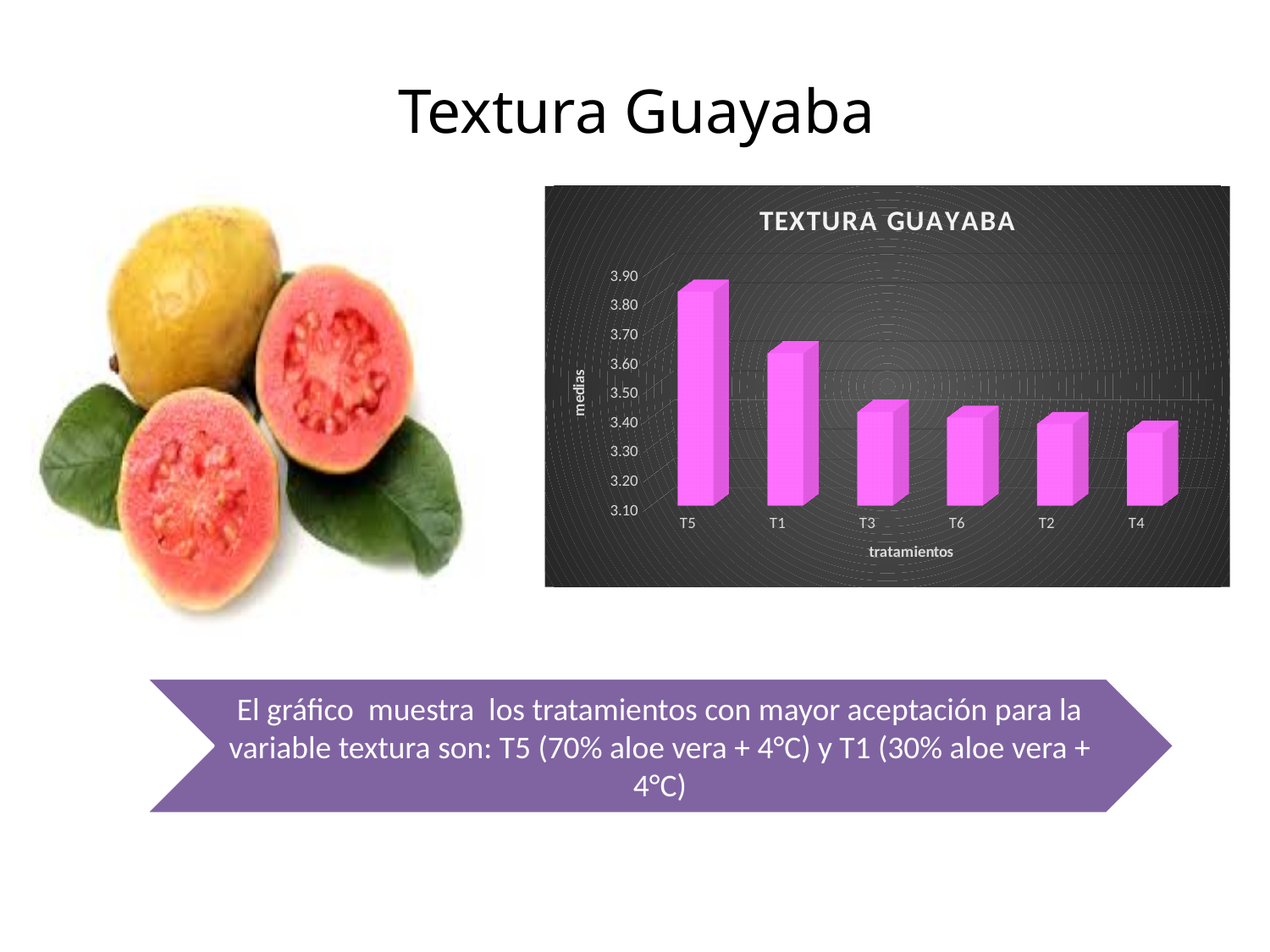
Do the values rise or fall moving from left to right along the x axis? fall Is the value for T3 greater or less than 3.30? greater Which has a larger value, T5 or T1? T5 How many treatments (categories) are plotted on the x axis of the chart? 6 Is the value for T1 greater or less than 3.50? greater Which has a larger value, T1 or T3? T1 What is the title of the chart? TEXTURA GUAYABA Is the value for T5 greater or less than 3.70? greater What kind of chart is shown on the slide? bar chart Which treatment has the lowest value in the chart? T4 Which treatment has the highest value in the chart? T5